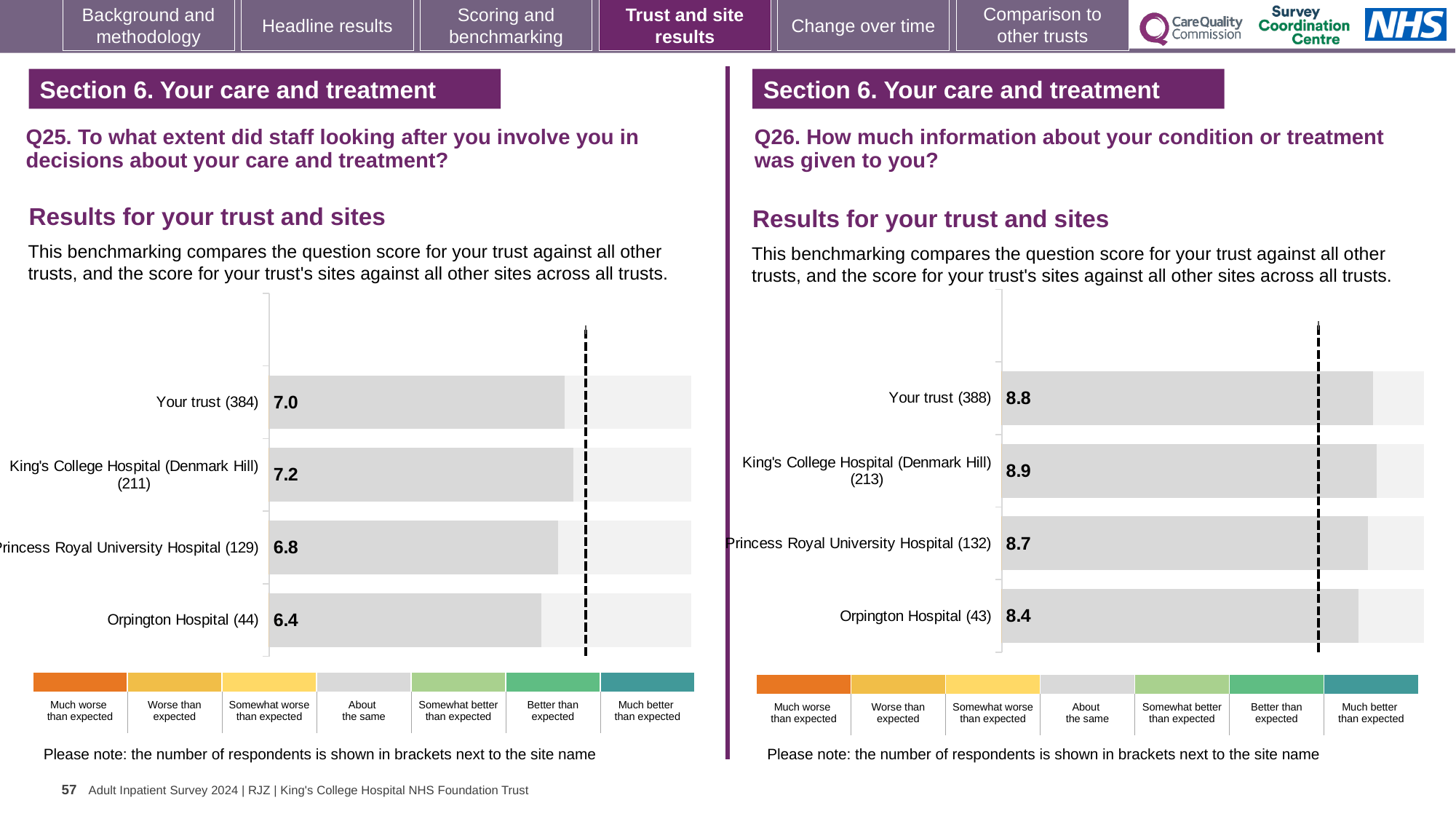
In the Q25 chart on the left, what is the difference between the scores for King's College Hospital (Denmark Hill) and Princess Royal University Hospital? 0.4 In the Q26 chart on the right, what is the difference between the scores for Your trust and Orpington Hospital? 0.4 In the Q25 chart on the left, how many bars are plotted? 4 In the Q26 chart on the right, what is the score for Princess Royal University Hospital? 8.7 In the Q26 chart on the right, which is larger: the score for Your trust or the score for Princess Royal University Hospital? Your trust What type of chart is used in the Q25 chart on the left? Bar chart In the Q26 chart on the right, what is the score for King's College Hospital (Denmark Hill)? 8.9 In the Q25 chart on the left, which site has the highest score? King's College Hospital (Denmark Hill) In the Q25 chart on the left, what is the score for Your trust? 7.0 In the Q25 chart on the left, what is the score for Orpington Hospital? 6.4 In the Q25 chart on the left, which site has the lowest score? Orpington Hospital In the Q26 chart on the right, which site has the lowest score? Orpington Hospital